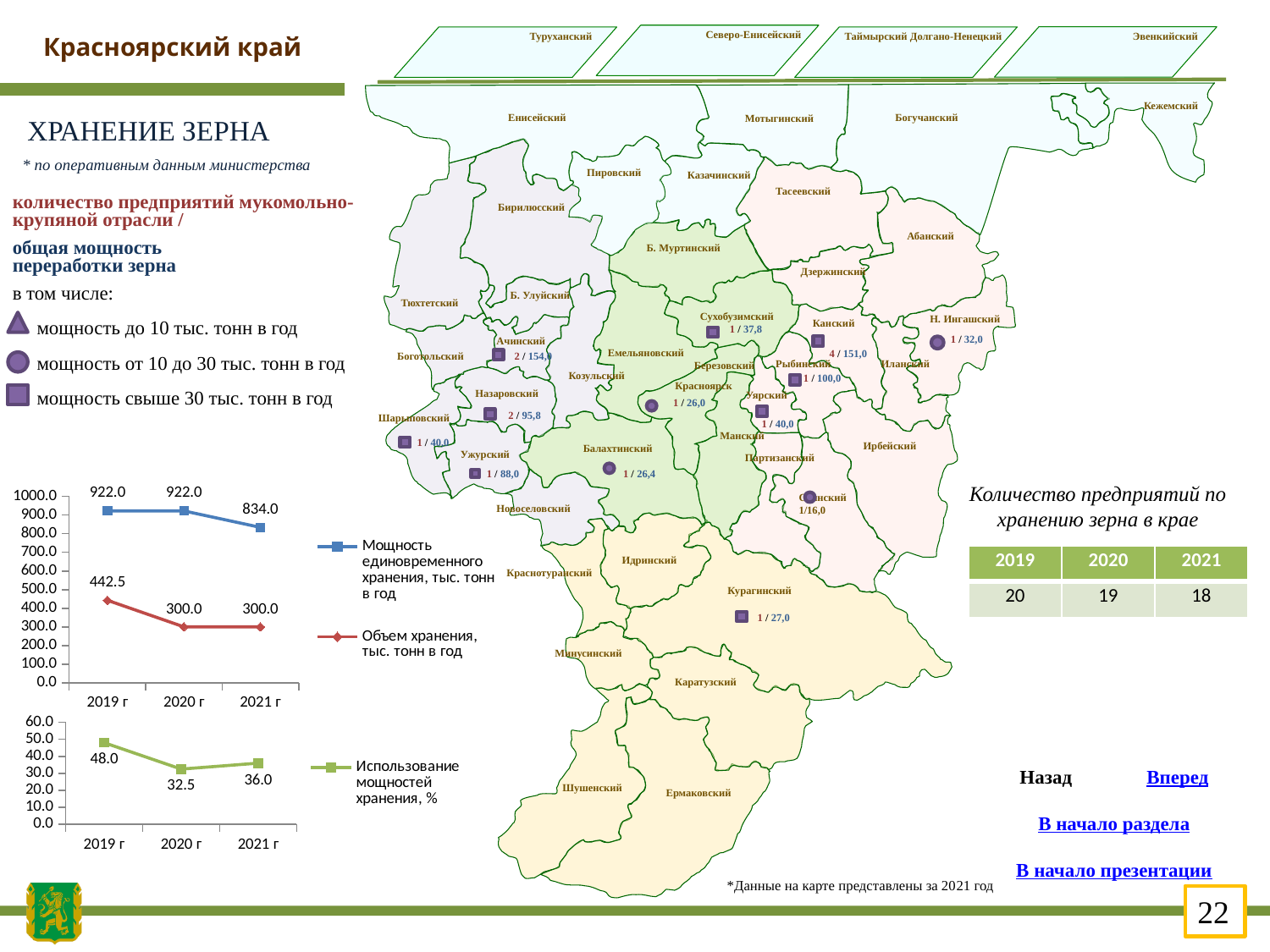
In the upper line chart, what is the value of 'Мощность единовременного хранения, тыс. тонн в год' for 2021 г? 834.0 In the upper line chart, what is the difference between 'Мощность единовременного хранения' and 'Объем хранения' in 2021 г? 534.0 What kind of chart is the lower chart showing 'Использование мощностей хранения, %'? Line chart In the lower line chart, what is the value of 'Использование мощностей хранения, %' for 2020 г? 32.5 In the upper line chart, which is larger in 2019 г: 'Мощность единовременного хранения' or 'Объем хранения'? Мощность единовременного хранения In the upper line chart, which year has the lowest value of 'Мощность единовременного хранения, тыс. тонн в год'? 2021 г How many years are plotted on the x axis of the lower line chart? 3 In the lower line chart, by how much did 'Использование мощностей хранения, %' fall from 2019 г to 2020 г? 15.5 How many series does the legend of the upper line chart list? 2 In the lower line chart, which year has the highest value of 'Использование мощностей хранения, %'? 2019 г In the upper line chart, does 'Объем хранения, тыс. тонн в год' rise or fall from 2019 г to 2020 г? Fall In the upper line chart, what is the value of 'Объем хранения, тыс. тонн в год' for 2019 г? 442.5